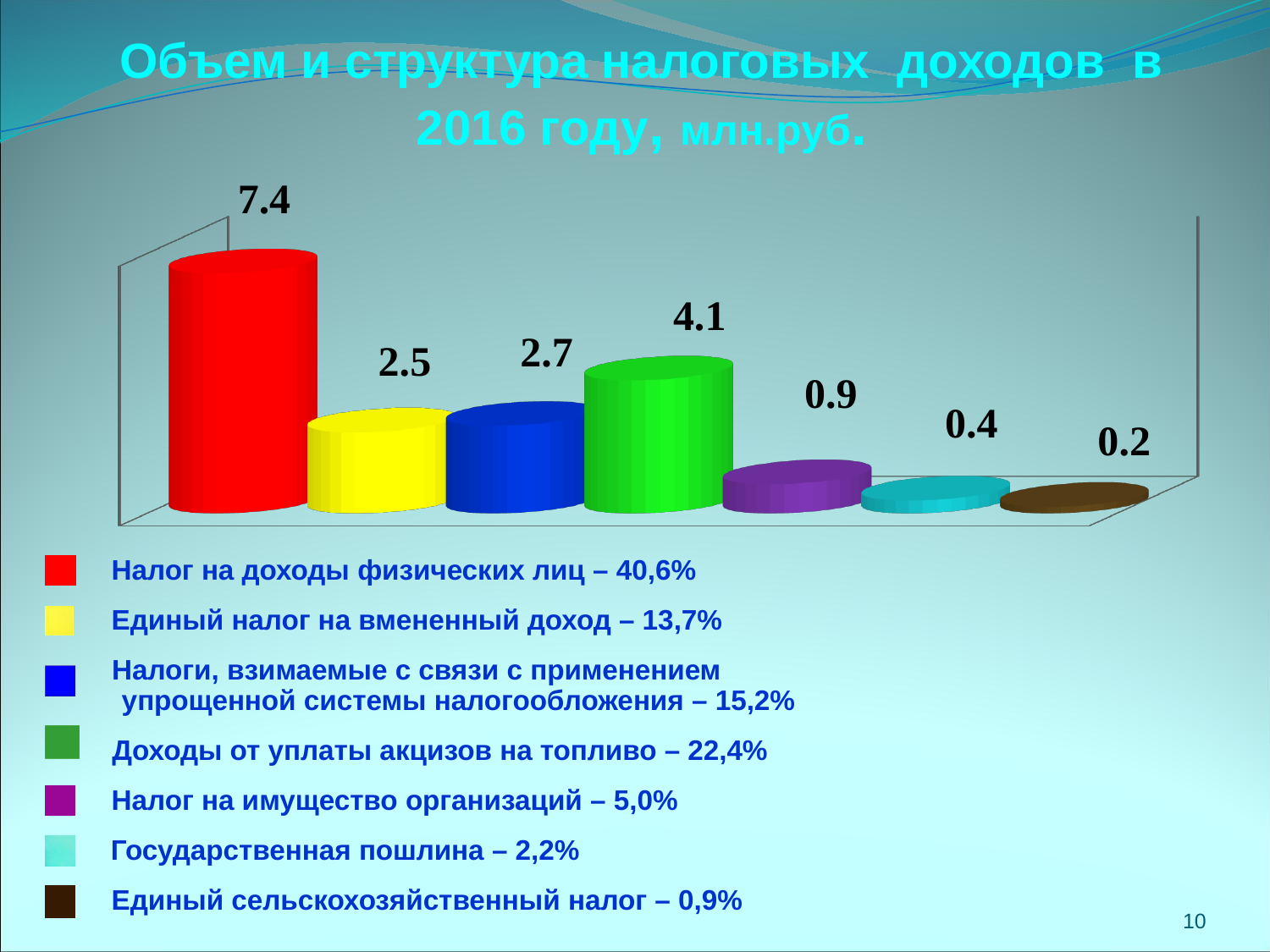
What is the title of the chart? Объем и структура налоговых доходов в 2016 году, млн.руб. How many bars are shown in the chart? 7 What is the value of the yellow bar (Единый налог на вмененный доход)? 2.5 What type of chart is shown on the slide? Bar chart What is the value of the brown bar (Единый сельскохозяйственный налог)? 0.2 What is the difference between the red bar (7.4) and the green bar (4.1)? 3.3 Which is larger: the blue bar (упрощенная система налогообложения) or the yellow bar (Единый налог на вмененный доход)? The blue bar (2.7) Which category has the highest value in the chart? Налог на доходы физических лиц (7.4) Which category has the lowest value in the chart? Единый сельскохозяйственный налог (0.2) What is the value of the green bar (Доходы от уплаты акцизов на топливо)? 4.1 What is the value of the red bar (Налог на доходы физических лиц)? 7.4 What share of tax revenues does Доходы от уплаты акцизов на топливо account for, according to the legend? 22,4%